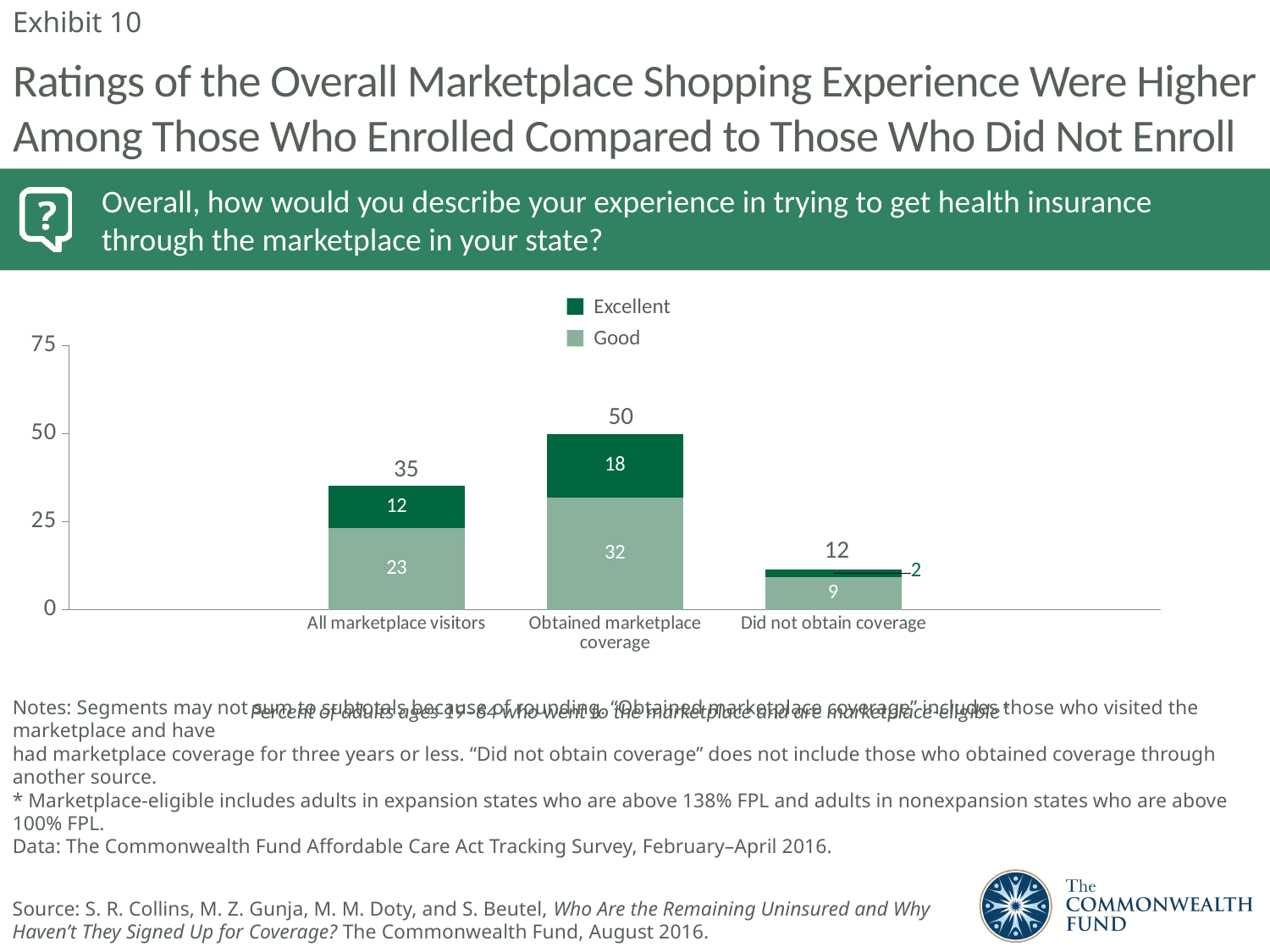
How many series does the legend list? 2 How many categories are shown on the x axis? 3 Which category has the lowest 'Good' value? Did not obtain coverage What is the 'Excellent' value for 'Did not obtain coverage'? 2 What is the 'Excellent' value for 'All marketplace visitors'? 12 What is the 'Good' value for 'Obtained marketplace coverage'? 32 Which is larger: the 'Excellent' value for 'Obtained marketplace coverage' or for 'All marketplace visitors'? Obtained marketplace coverage What is the difference between the 'Good' values for 'Obtained marketplace coverage' and 'All marketplace visitors'? 9 What is the total shown above the bar for 'Did not obtain coverage'? 12 What kind of chart is shown? Stacked bar chart Which category has the highest total? Obtained marketplace coverage What is the total shown above the bar for 'Obtained marketplace coverage'? 50